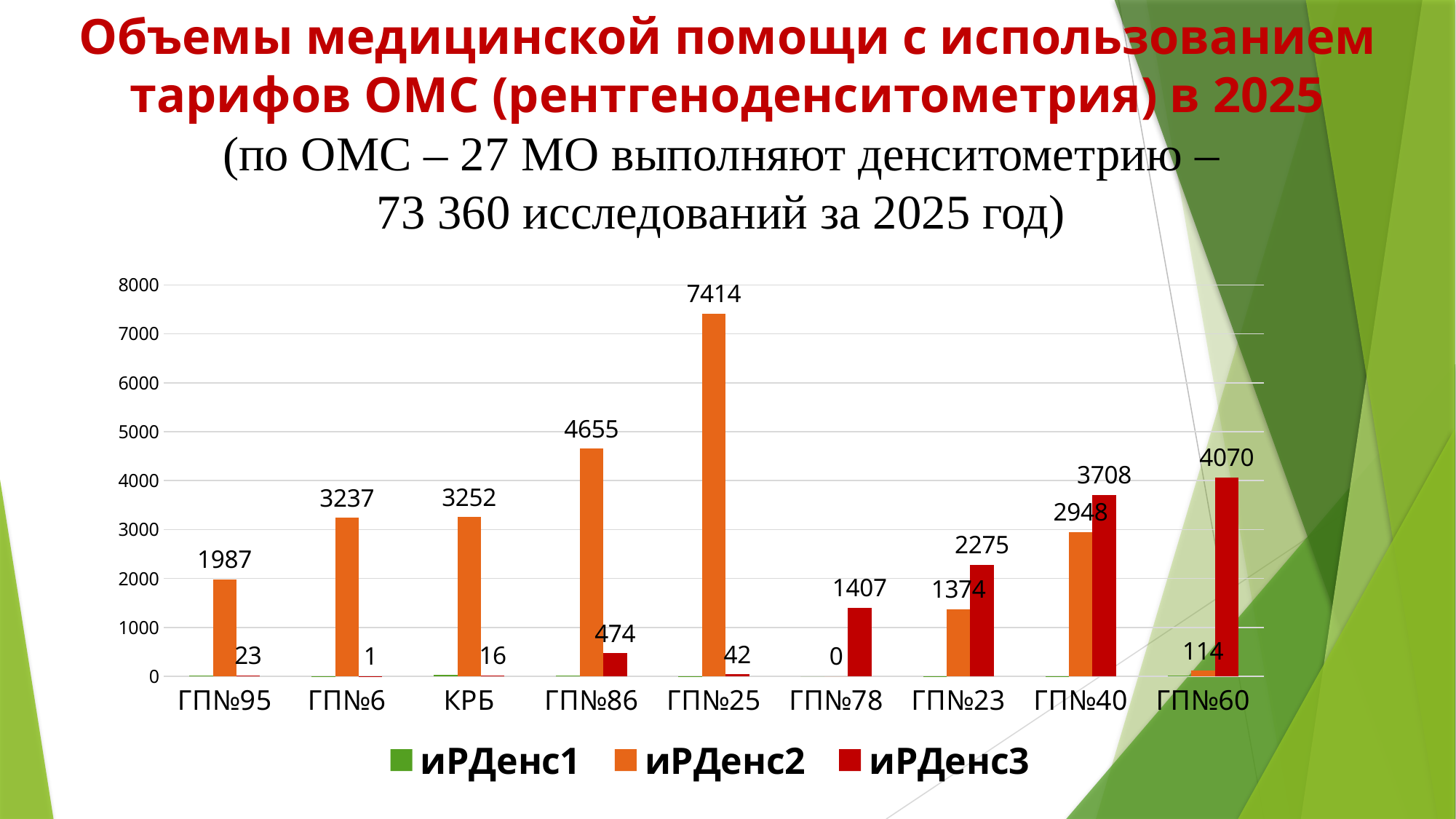
What is the value of иРДенс3 for ГП№78? 1407 Which category has the lowest иРДенс3 value? ГП№6 What is the difference between иРДенс2 and иРДенс3 for ГП№86? 4181 How many categories are shown on the x axis? 9 How many series does the legend list? 3 Which category has the highest иРДенс3 value? ГП№60 What is the value of иРДенс2 for ГП№25? 7414 What is the value of иРДенс3 for ГП№40? 3708 What is the difference between the иРДенс2 values for ГП№25 and ГП№86? 2759 For ГП№40, which is larger: иРДенс2 or иРДенс3? иРДенс3 What kind of chart is shown on the slide? bar chart Which category has the highest иРДенс2 value? ГП№25